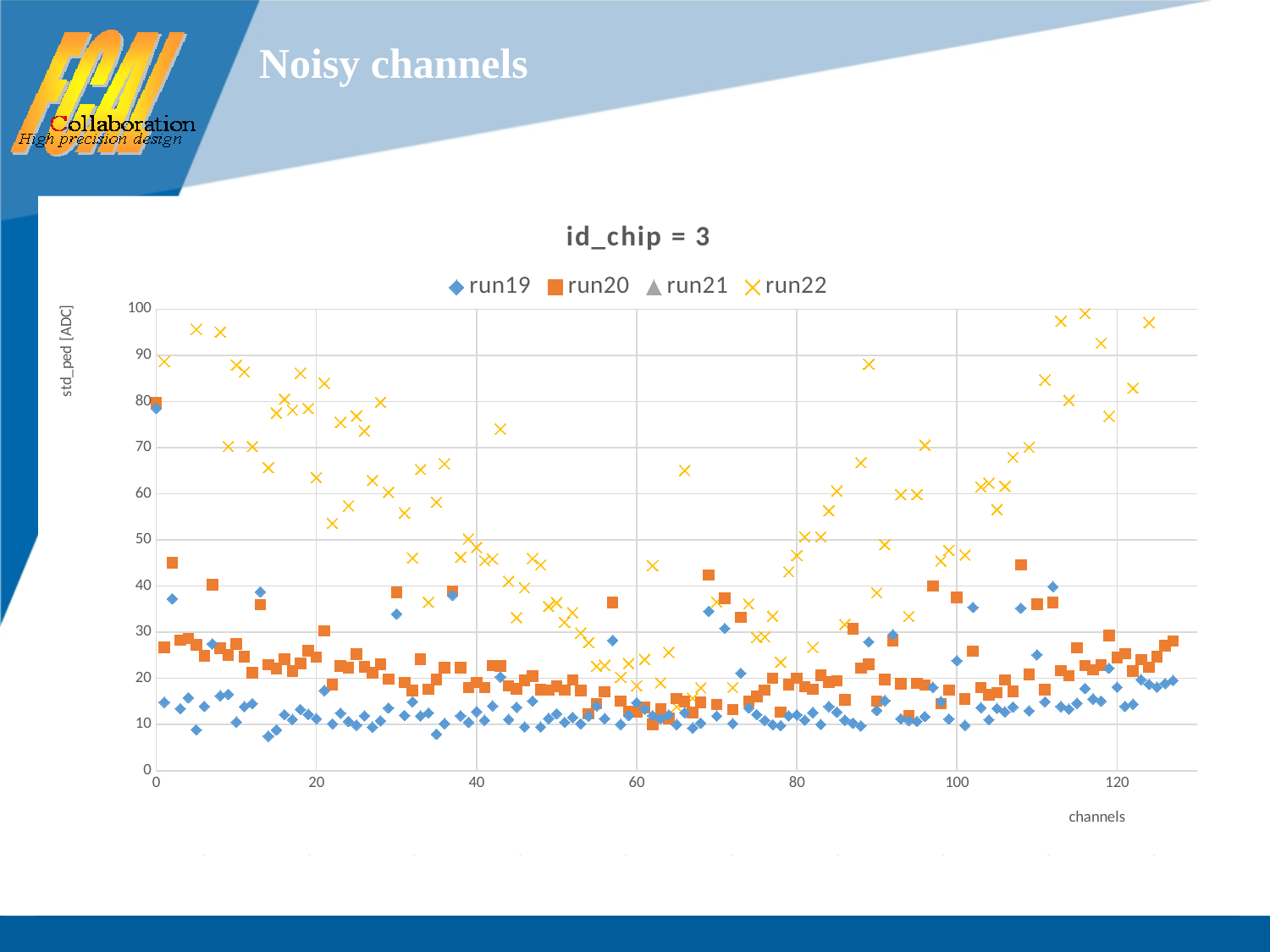
What is the label of the vertical axis? std_ped [ADC] What is the title of the chart? id_chip = 3 Is the run20 value at channel 62 greater or less than 20? less Is the run19 value at channel 2 greater or less than 30? greater Do the run22 values rise or fall from channel 0 to channel 60? fall What kind of chart is shown on the slide? scatter chart Which series reaches the highest values on the chart? run22 At channel 2, which series has the larger value, run19 or run20? run20 Is the run20 value at channel 2 greater or less than 40? greater How many series does the legend list? 4 What is the highest tick value shown on the vertical axis? 100